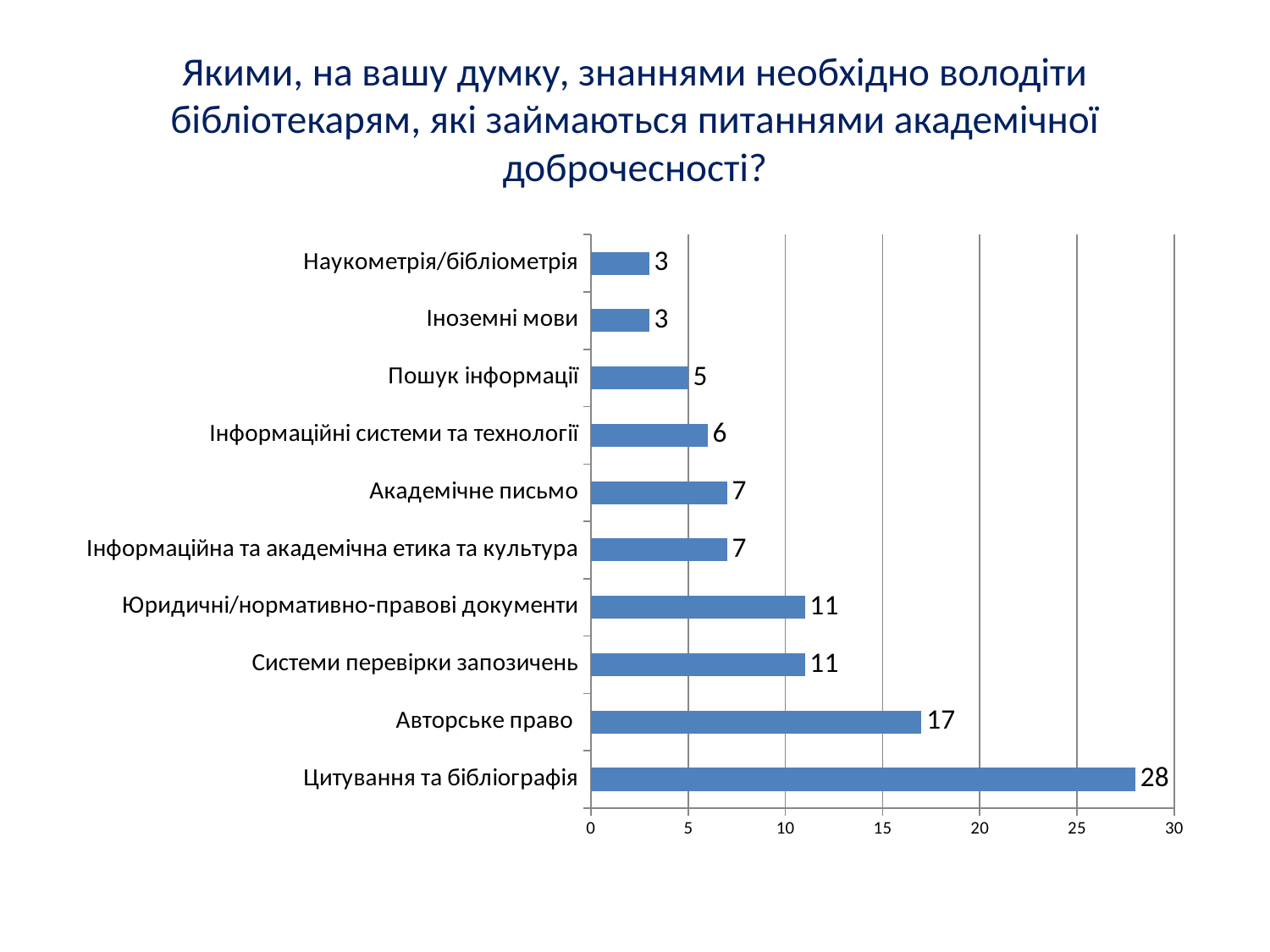
What is the value for Цитування та бібліографія? 28 What is the maximum value shown on the horizontal axis? 30 Is the value for Авторське право greater or less than 15? greater What is the value for Авторське право? 17 Which category has the highest value? Цитування та бібліографія What is the value for Інформаційні системи та технології? 6 What is the value for Пошук інформації? 5 What is the difference between the values for Цитування та бібліографія and Авторське право? 11 How many categories are shown in the chart? 10 What is the difference between the values for Системи перевірки запозичень and Академічне письмо? 4 What kind of chart is shown on the slide? bar chart Which is larger, the value for Авторське право or the value for Юридичні/нормативно-правові документи? Авторське право